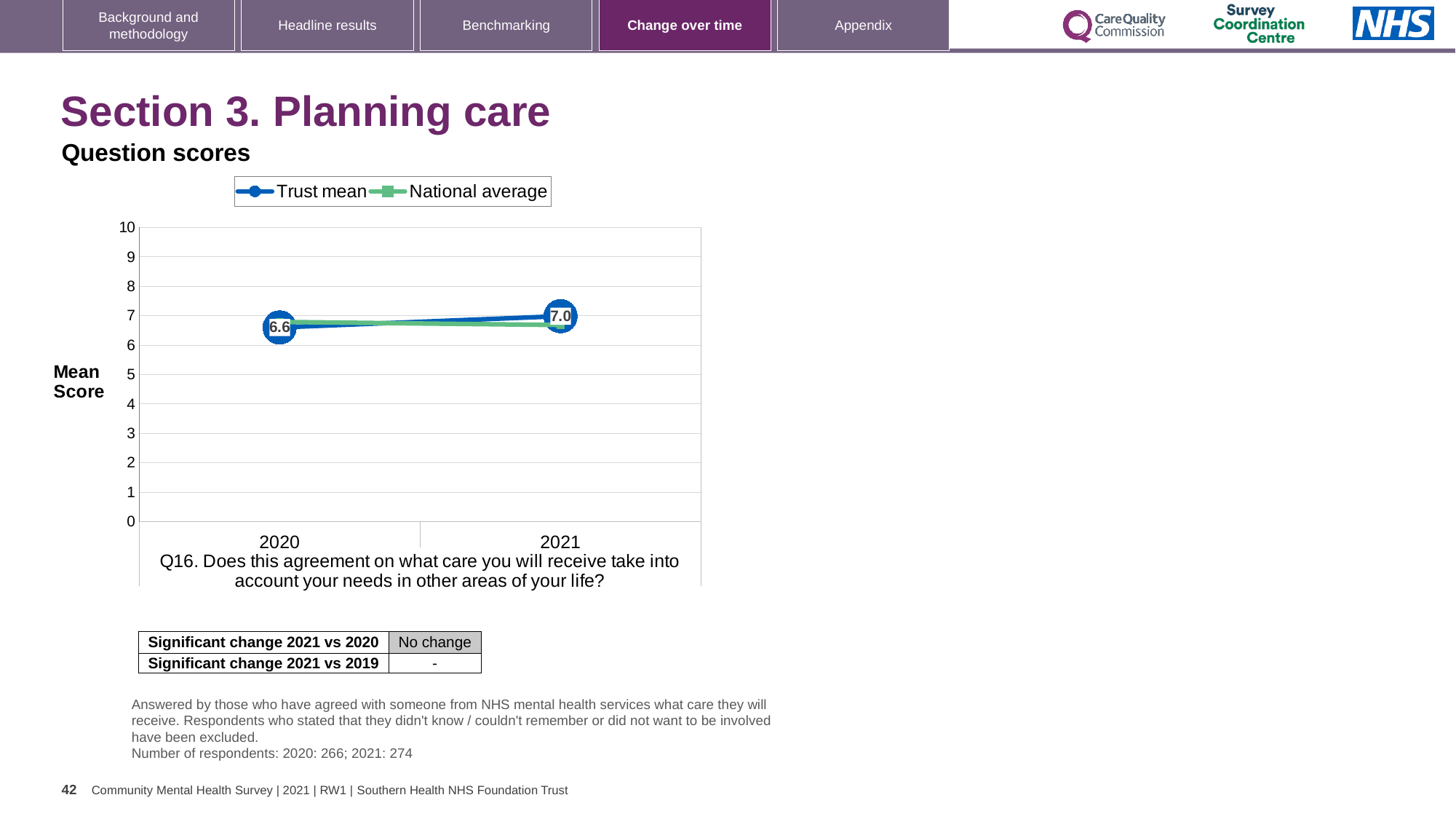
How many years are shown on the x axis of the chart? 2 Is the National average value for 2021 greater or less than 5? greater What is the Trust mean score for 2021? 7.0 Does the Trust mean score rise or fall from 2020 to 2021? Rise What kind of chart is shown on the slide? Line chart Which is larger, the Trust mean score in 2020 or in 2021? 2021 What is the difference between the Trust mean score in 2021 and in 2020? 0.4 How many series does the chart legend list? 2 Is the National average value for 2020 greater or less than 8? less In which year is the Trust mean score highest? 2021 What is the Trust mean score for 2020? 6.6 In which year is the Trust mean score lowest? 2020